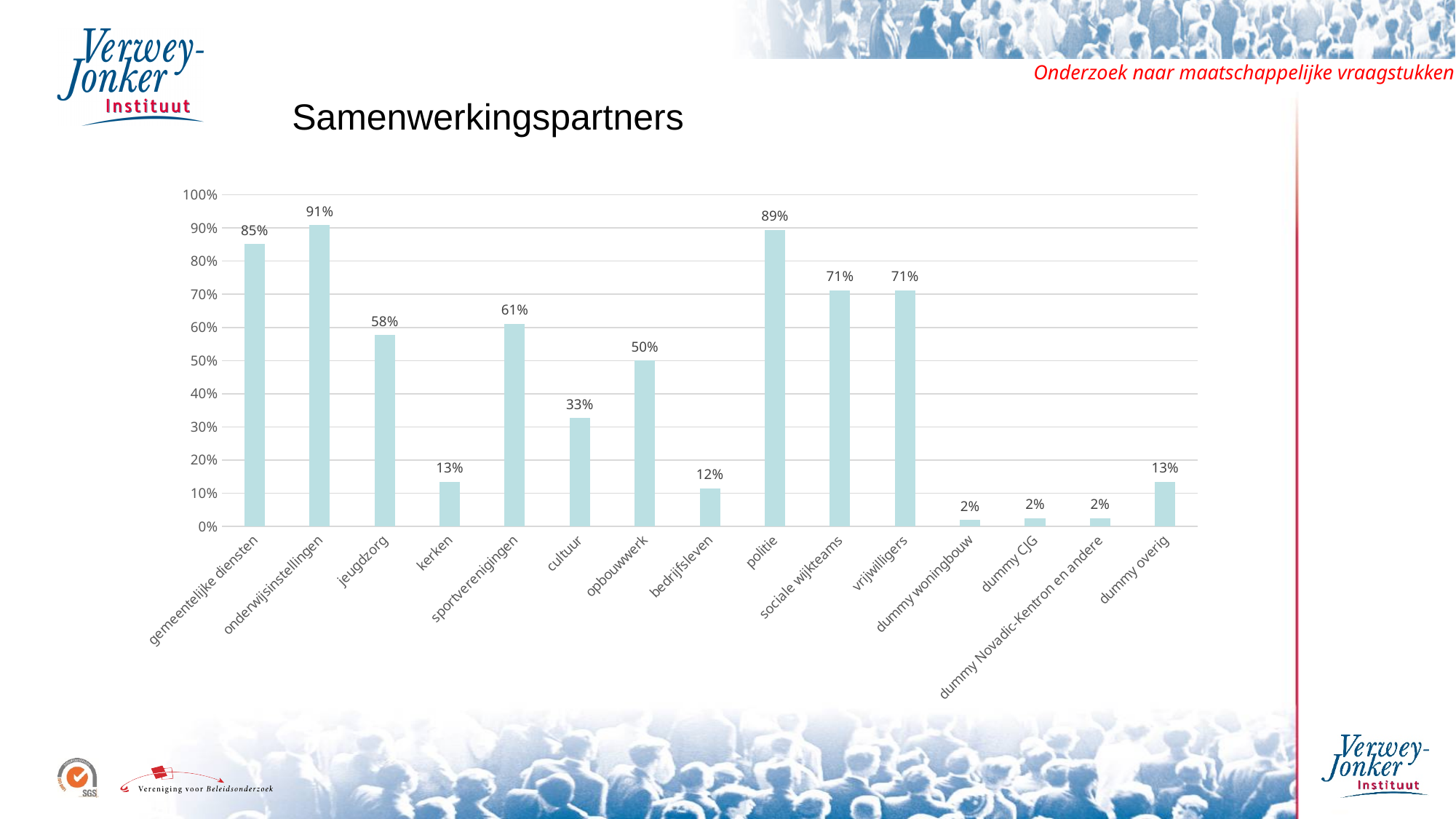
How many categories are shown on the x axis? 15 What is the difference between the values for sportverenigingen and cultuur? 28% What is the difference between the values for onderwijsinstellingen and gemeentelijke diensten? 6% What is the value for sociale wijkteams? 71% What is the value for bedrijfsleven? 12% What is the value for jeugdzorg? 58% What is the title of the slide? Samenwerkingspartners Which is larger, the value for opbouwwerk or the value for cultuur? opbouwwerk What is the value for politie? 89% Which category has the highest value? onderwijsinstellingen What kind of chart is shown on the slide? bar chart Which is larger, the value for kerken or the value for dummy woningbouw? kerken